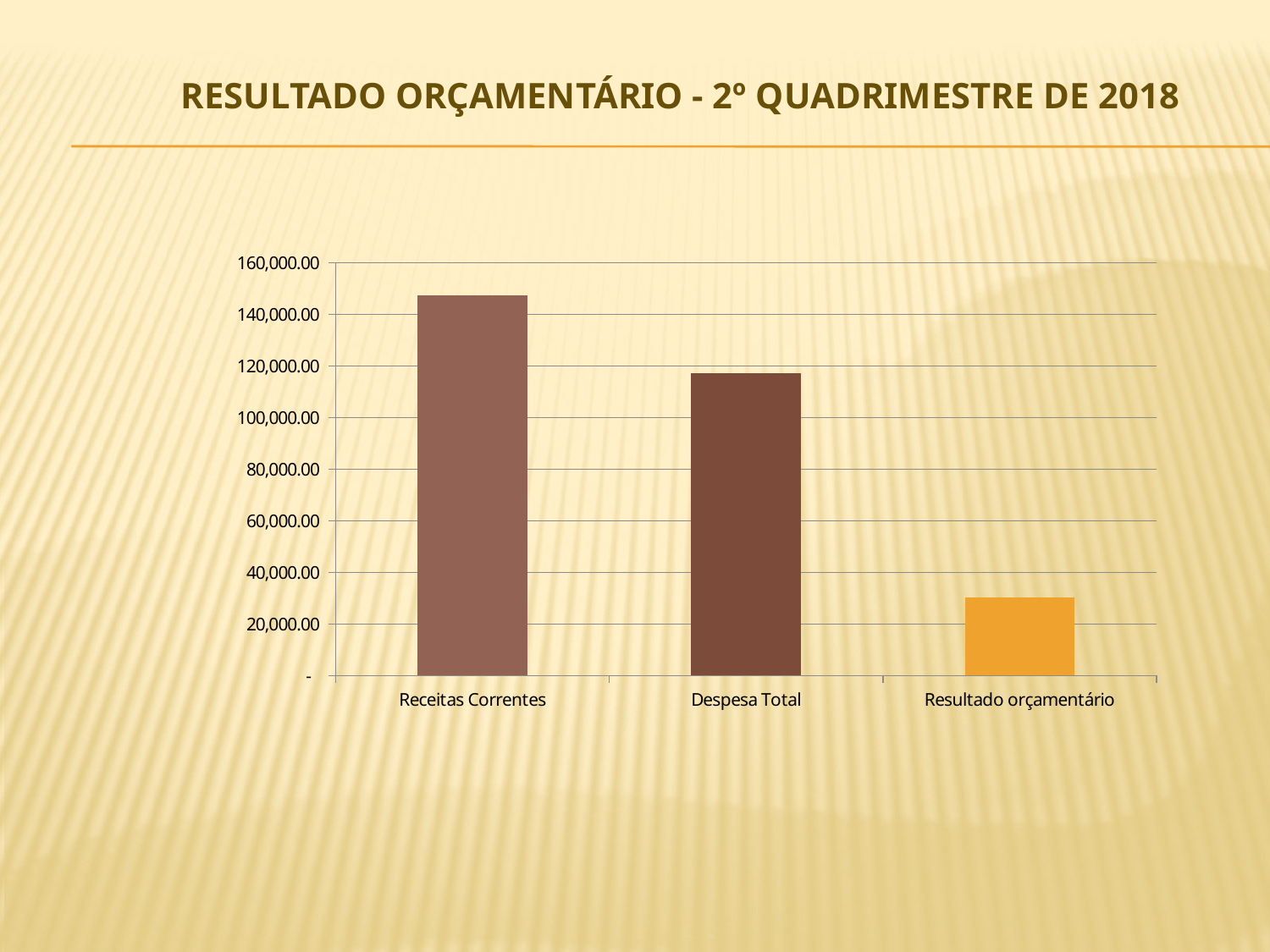
Is the value for Despesa Total greater or less than 100,000.00? greater Is the value for Resultado orçamentário greater or less than 40,000.00? less Which is larger, Despesa Total or Resultado orçamentário? Despesa Total What is the title of the slide containing the chart? RESULTADO ORÇAMENTÁRIO - 2º QUADRIMESTRE DE 2018 Which category has the highest value in the chart? Receitas Correntes Which category has the lowest value in the chart? Resultado orçamentário Is the value for Receitas Correntes greater or less than 140,000.00? greater Which is larger, Receitas Correntes or Despesa Total? Receitas Correntes What is the highest value shown on the y axis of the chart? 160,000.00 What type of chart is shown on the slide? bar chart How many categories are shown on the x axis of the chart? 3